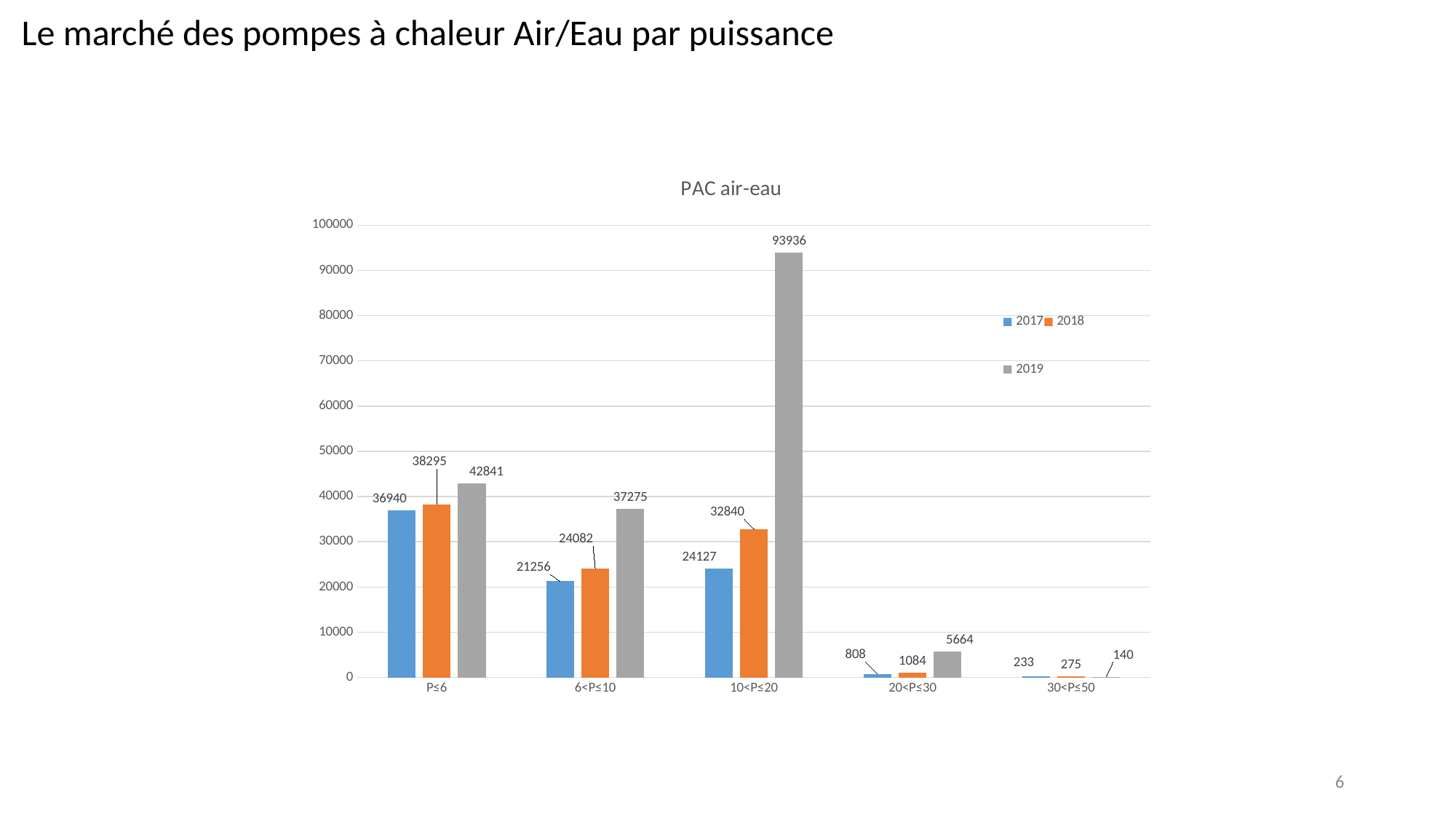
What is the value for 2017 in the P≤6 category? 36940 How many series does the legend list? 3 What is the title of the chart? PAC air-eau Which category has the highest value for 2019? 10<P≤20 What is the value for 2018 in the 20<P≤30 category? 1084 What is the value for 2019 in the 10<P≤20 category? 93936 Is the value for 2019 in the P≤6 category greater or less than 40000? greater Which is larger in the 6<P≤10 category: the 2018 value or the 2019 value? 2019 Which category has the lowest value for 2017? 30<P≤50 What is the difference between the 2019 and 2017 values in the 10<P≤20 category? 69809 How many power categories are shown on the x axis? 5 What kind of chart is shown on the slide? bar chart